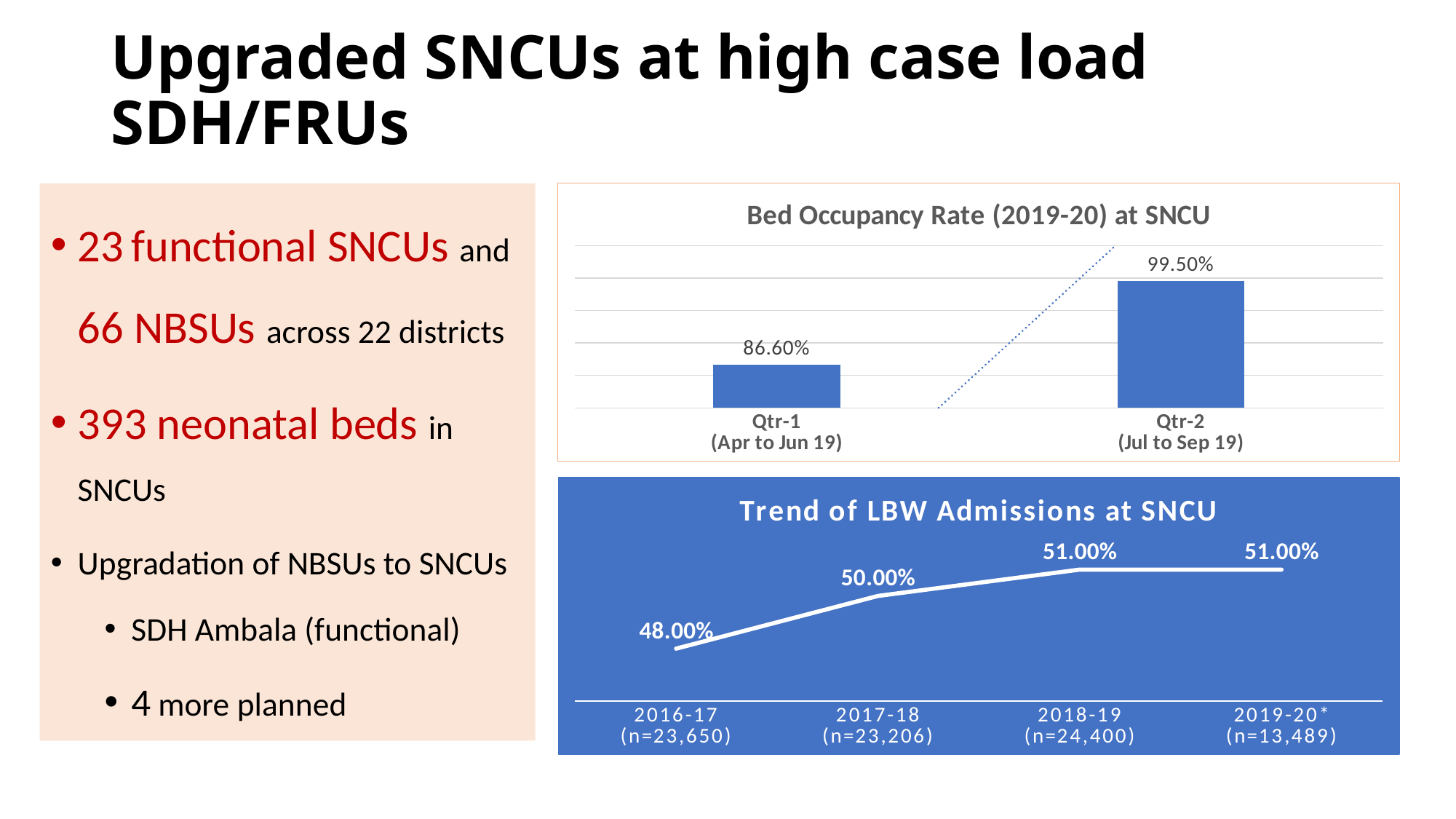
In the 'Bed Occupancy Rate (2019-20) at SNCU' chart, which quarter has the higher bed occupancy rate? Qtr-2 (Jul to Sep 19) In the 'Bed Occupancy Rate (2019-20) at SNCU' chart, by how many percentage points did the bed occupancy rate increase from Qtr-1 to Qtr-2? 12.90% In the 'Bed Occupancy Rate (2019-20) at SNCU' chart, what is the bed occupancy rate for Qtr-1 (Apr to Jun 19)? 86.60% In the 'Trend of LBW Admissions at SNCU' chart, which year has the lowest LBW admission share? 2016-17 In the 'Bed Occupancy Rate (2019-20) at SNCU' chart, how many quarters are plotted? 2 In the 'Trend of LBW Admissions at SNCU' chart, do the values rise or fall from 2016-17 to 2019-20*? Rise What type of chart is the 'Bed Occupancy Rate (2019-20) at SNCU' chart? Bar chart In the 'Trend of LBW Admissions at SNCU' chart, what is the value for 2019-20*? 51.00% What type of chart is the 'Trend of LBW Admissions at SNCU' chart? Line chart In the 'Trend of LBW Admissions at SNCU' chart, what is the value for 2017-18? 50.00% In the 'Trend of LBW Admissions at SNCU' chart, what is the value for 2016-17? 48.00% In the 'Bed Occupancy Rate (2019-20) at SNCU' chart, what is the bed occupancy rate for Qtr-2 (Jul to Sep 19)? 99.50%